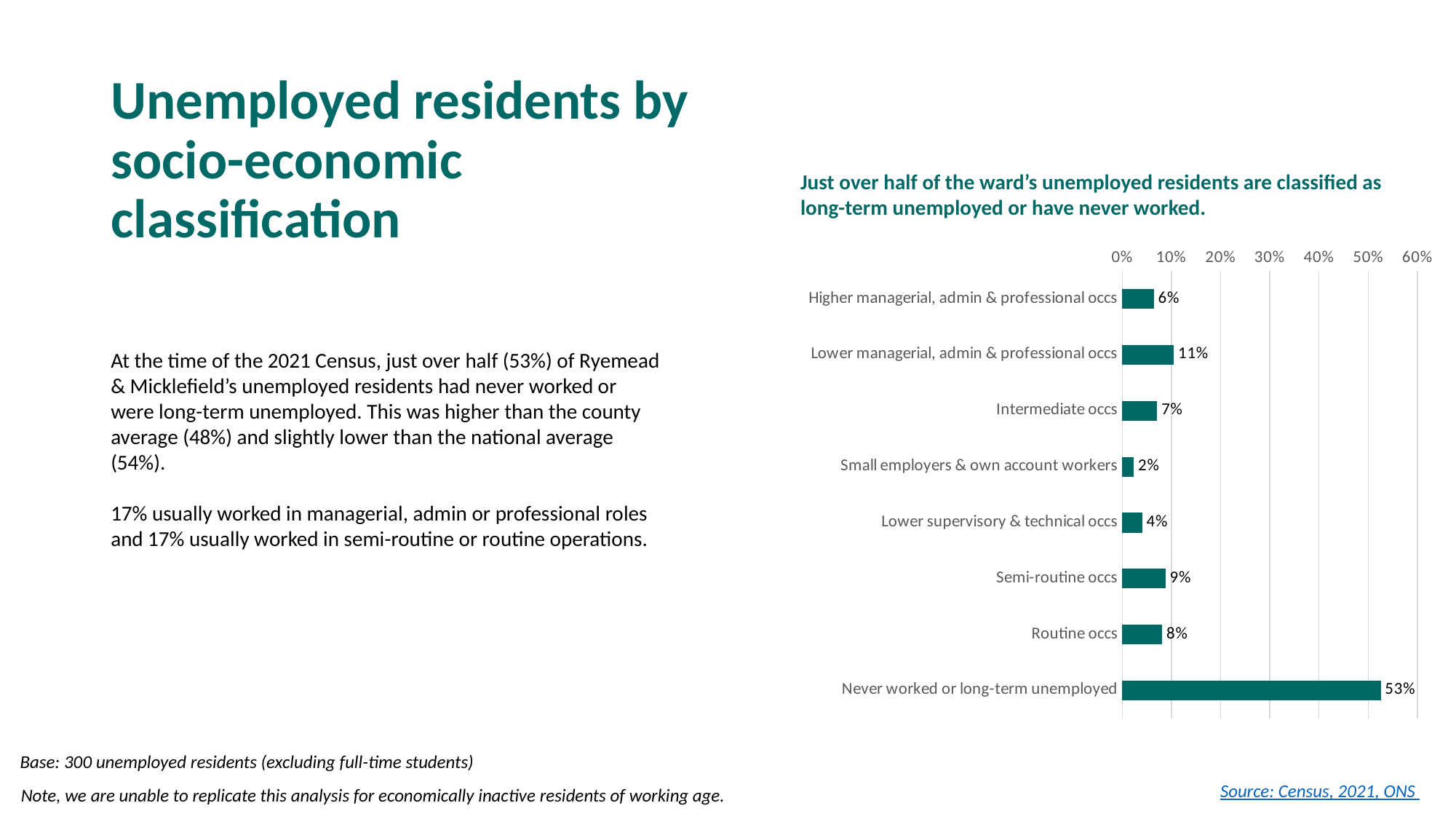
Is the value for 'Never worked or long-term unemployed' greater or less than 50%? greater Which category has the lowest value? Small employers & own account workers What is the difference between 'Semi-routine occs' and 'Routine occs'? 1% Which is larger: 'Intermediate occs' or 'Lower supervisory & technical occs'? Intermediate occs What is the value for 'Small employers & own account workers'? 2% What is the difference between 'Never worked or long-term unemployed' and 'Lower managerial, admin & professional occs'? 42% What is the value for 'Lower managerial, admin & professional occs'? 11% Which category has the highest value? Never worked or long-term unemployed What percentage of unemployed residents are classified as 'Never worked or long-term unemployed'? 53% What type of chart is shown on the slide? Bar chart How many categories are shown in the chart? 8 What is the value for 'Semi-routine occs'? 9%